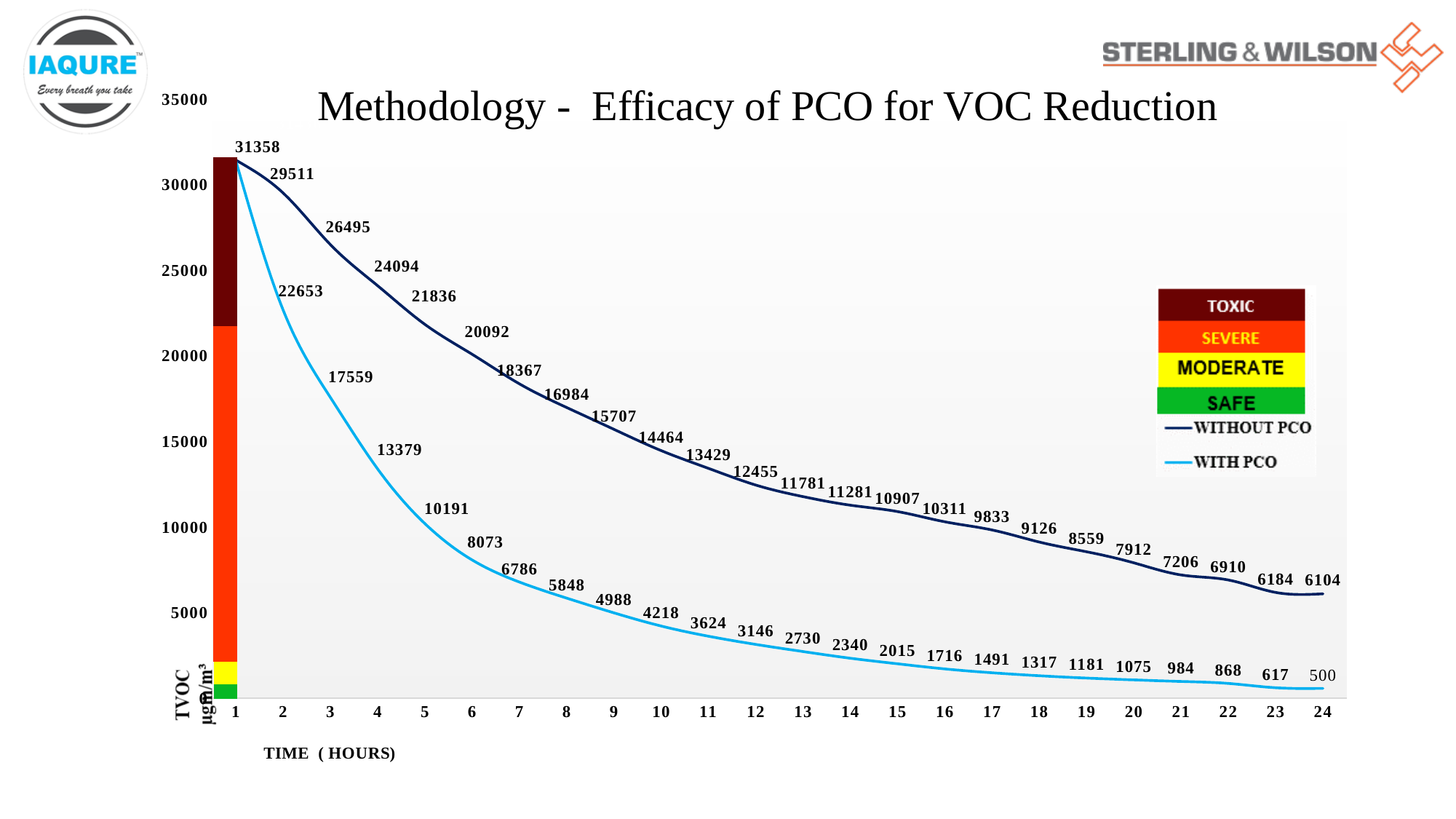
How many hourly data points are plotted for each series? 24 What kind of chart is shown on the slide? Line chart What is the TVOC value for WITH PCO at hour 5? 10191 At which hour does the WITH PCO series reach its lowest value? 24 What is the difference between the WITHOUT PCO and WITH PCO values at hour 24? 5604 What is the TVOC value for WITHOUT PCO at hour 24? 6104 What is the TVOC value for WITHOUT PCO at hour 12? 12455 What is the difference between the WITHOUT PCO and WITH PCO values at hour 2? 6858 Do the TVOC values rise or fall over time for the WITH PCO series? Fall How many data series does the legend list for the plotted lines? 2 What is the TVOC value for WITH PCO at hour 24? 500 Which series has the higher value at hour 10, WITHOUT PCO or WITH PCO? WITHOUT PCO